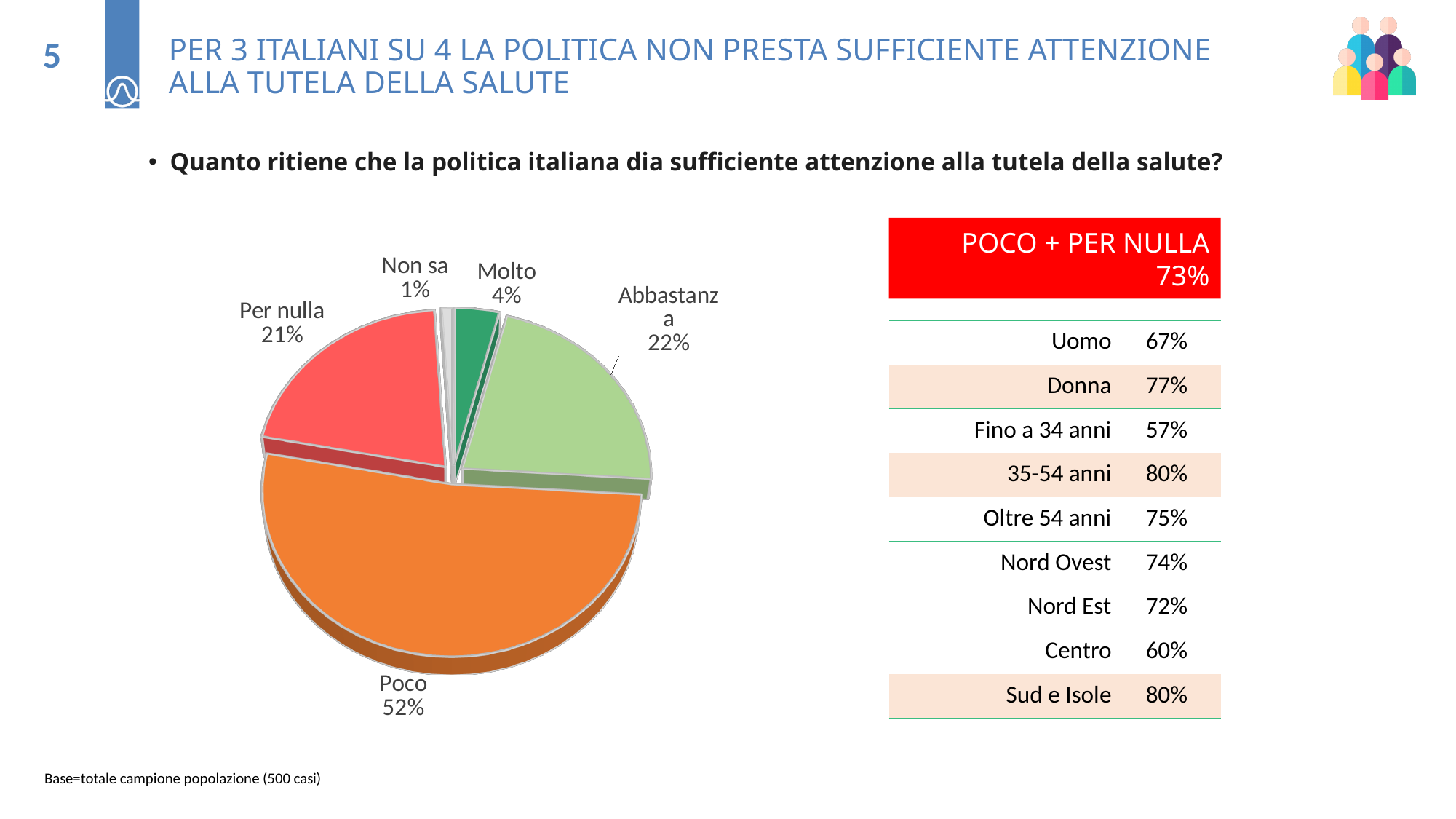
What is the combined share of the "Poco" and "Per nulla" slices in the pie chart? 73% What share of the pie chart is labelled "Abbastanza"? 22% What share of the pie chart is labelled "Non sa"? 1% Which slice is larger in the pie chart, "Per nulla" or "Abbastanza"? Abbastanza Which slice of the pie chart is the smallest? Non sa What share of the pie chart is labelled "Per nulla"? 21% How many slices does the pie chart have? 5 What share of the pie chart is labelled "Molto"? 4% What share of the pie chart is labelled "Poco"? 52% What is the difference in percentage points between the "Poco" slice and the "Abbastanza" slice? 30 What kind of chart is shown on the slide? Pie chart Which slice of the pie chart is the largest? Poco